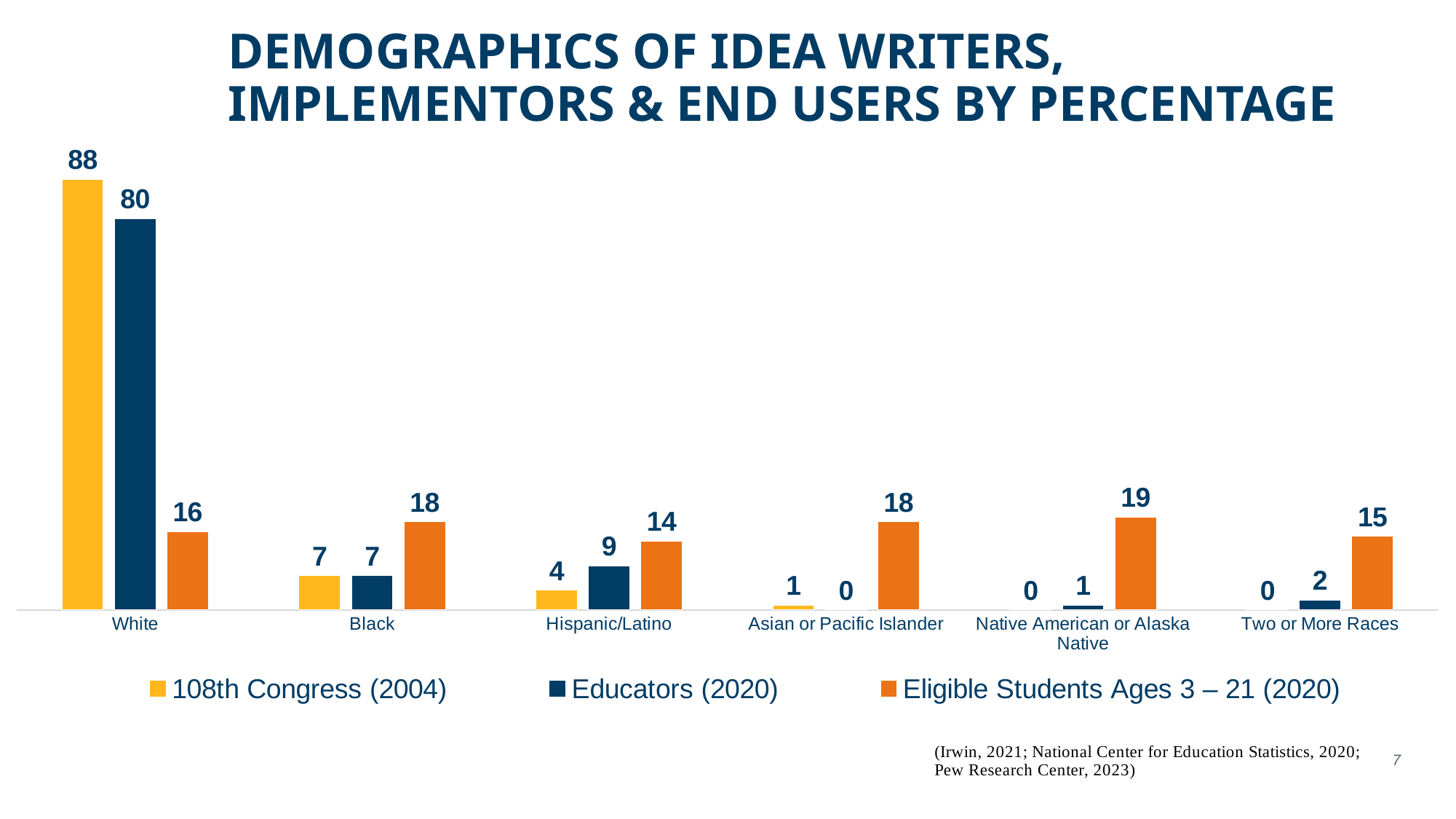
How many categories are shown on the x axis? 6 Which series is shown in orange in the legend? Eligible Students Ages 3 – 21 (2020) What is the value for Hispanic/Latino in the Eligible Students Ages 3 – 21 (2020) series? 14 What is the difference between the Eligible Students Ages 3 – 21 (2020) value and the 108th Congress (2004) value for Asian or Pacific Islander? 17 What is the difference between the 108th Congress (2004) value and the Educators (2020) value for White? 8 What is the value for Two or More Races in the Educators (2020) series? 2 Which category has the highest value in the Eligible Students Ages 3 – 21 (2020) series? Native American or Alaska Native How many series does the legend list? 3 Which category has the lowest value in the Educators (2020) series? Asian or Pacific Islander What kind of chart is shown on the slide? Bar chart What is the value for White in the 108th Congress (2004) series? 88 For Black, which series has the larger value: Educators (2020) or Eligible Students Ages 3 – 21 (2020)? Eligible Students Ages 3 – 21 (2020)